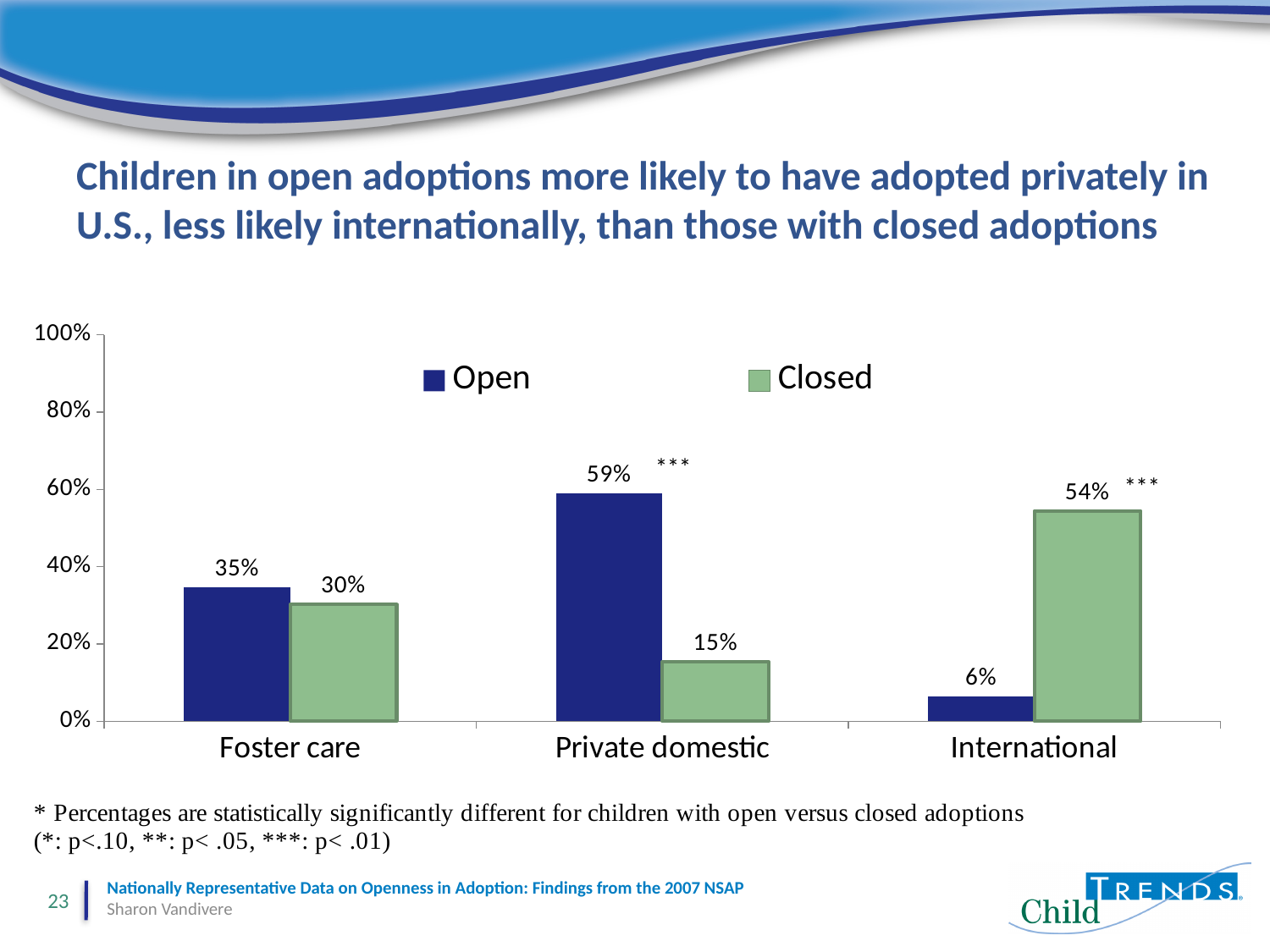
Which is larger in the Foster care category, Open or Closed? Open What is the value for Open in the Foster care category? 35% What is the value for Closed in the Private domestic category? 15% What is the value for Open in the International category? 6% Is the value for Closed in the International category greater or less than 40%? greater Which category has the highest value for the Open series? Private domestic What is the difference between the Open and Closed values in the Private domestic category? 44% What is the value for Closed in the International category? 54% How many categories are shown on the x axis? 3 Which category has the lowest value for the Closed series? Private domestic What kind of chart is shown on the slide? Bar chart How many series does the legend list? 2